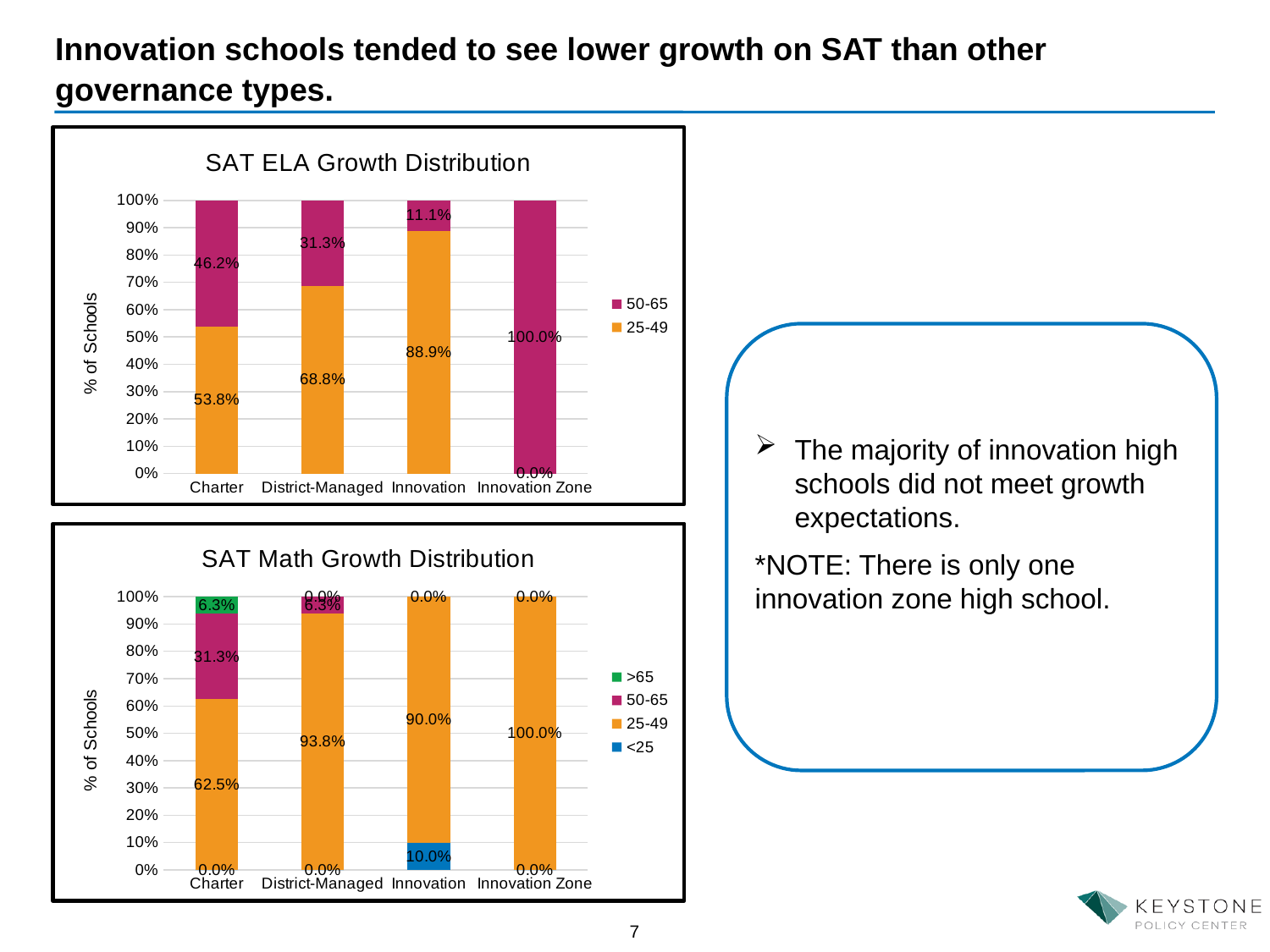
In the SAT Math Growth Distribution chart, which governance type has the highest 25-49 share? Innovation Zone In the SAT Math Growth Distribution chart, what percentage of Innovation schools fall in the <25 band? 10.0% In the SAT ELA Growth Distribution chart, what is the difference between the 25-49 and 50-65 shares for Charter schools? 7.6% How many series does the legend of the SAT ELA Growth Distribution chart list? 2 In the SAT Math Growth Distribution chart, what is the 25-49 value for District-Managed schools? 93.8% What kind of chart is the SAT Math Growth Distribution chart? Stacked bar chart In the SAT ELA Growth Distribution chart, what is the 50-65 value for District-Managed schools? 31.3% In the SAT ELA Growth Distribution chart, what is the 25-49 value for Innovation schools? 88.9% In the SAT Math Growth Distribution chart, what is the >65 value for Charter schools? 6.3% How many series does the legend of the SAT Math Growth Distribution chart list? 4 In the SAT ELA Growth Distribution chart, which governance type has the highest 50-65 share? Innovation Zone In the SAT ELA Growth Distribution chart, what percentage of Charter schools fall in the 25-49 growth band? 53.8%